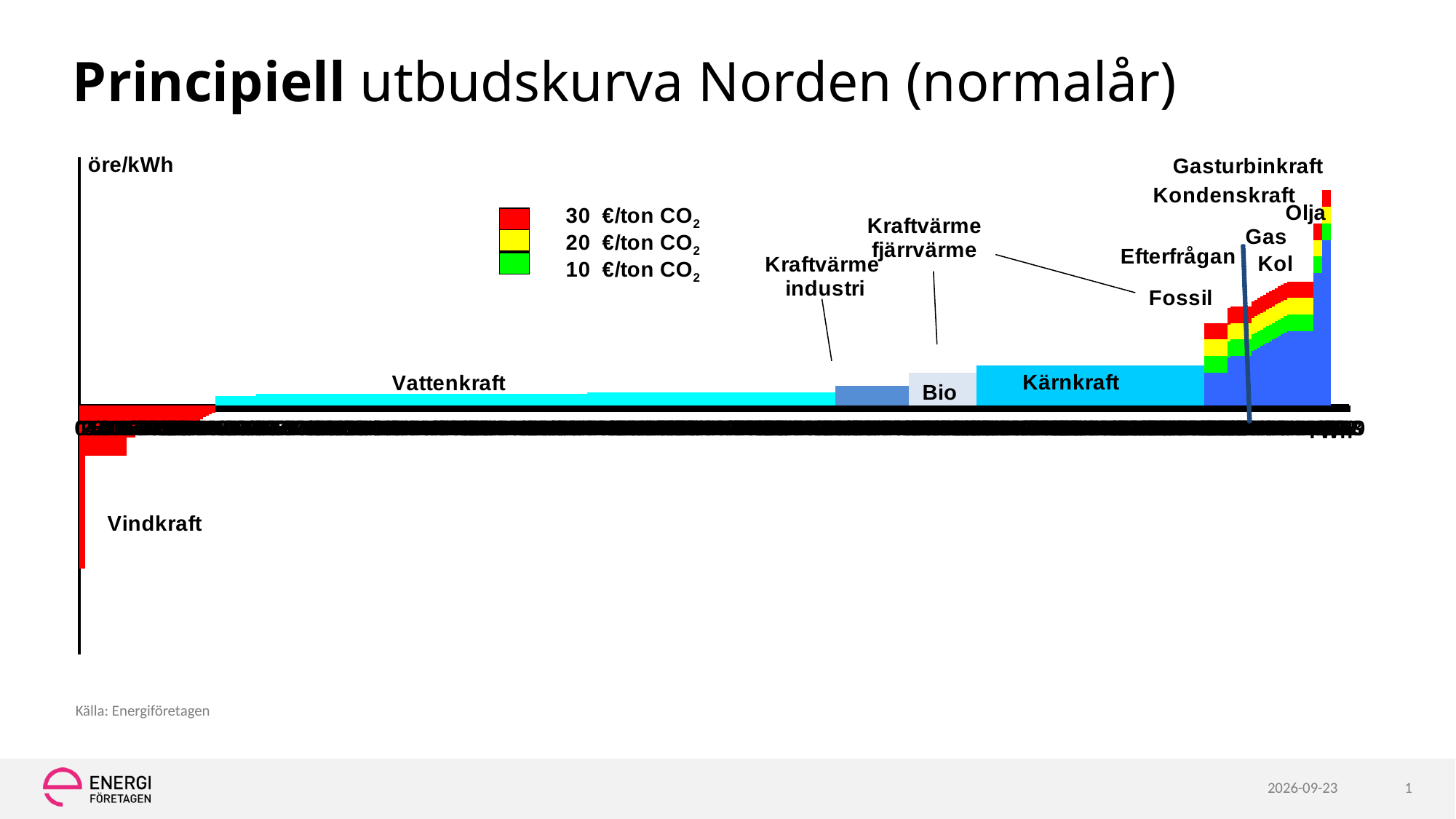
Which is plotted higher on the curve, Fossil or Bio? Fossil Which technology is plotted below the horizontal axis, with a negative value? Vindkraft Which technology is at the highest point of the supply curve? Gasturbinkraft Is Bio plotted higher or lower on the curve than Kärnkraft? Lower Is Kärnkraft plotted higher or lower on the curve than Vattenkraft? Higher What unit is shown on the vertical axis of the chart? öre/kWh Do the values of the supply curve rise or fall from left to right? Rise How many CO2 price levels does the legend list? 3 Which colour in the legend represents 30 €/ton CO2? Red